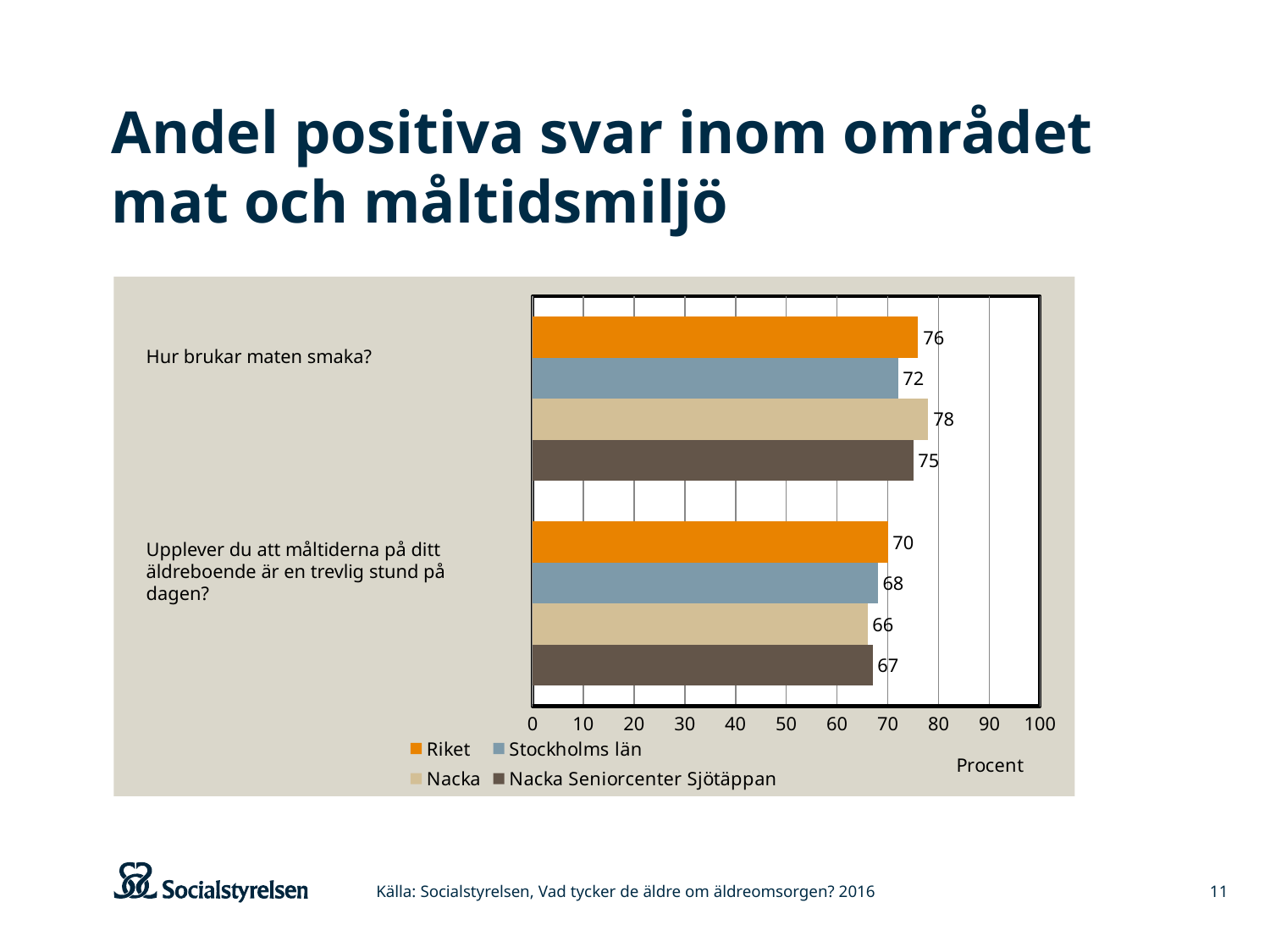
What is the difference between the Nacka value and the Stockholms län value for "Hur brukar maten smaka?"? 6 What kind of chart is shown on the slide? Bar chart What unit is shown on the x axis of the chart? Procent How many questions (categories) are shown on the chart? 2 What is the value for Stockholms län for "Hur brukar maten smaka?"? 72 For "Upplever du att måltiderna på ditt äldreboende är en trevlig stund på dagen?", which is larger: Riket or Stockholms län? Riket Which series has the lowest value for "Upplever du att måltiderna på ditt äldreboende är en trevlig stund på dagen?"? Nacka How many series does the legend list? 4 What is the value for Riket for the question "Hur brukar maten smaka?"? 76 What is the value for Nacka Seniorcenter Sjötäppan for "Upplever du att måltiderna på ditt äldreboende är en trevlig stund på dagen?"? 67 Is the Nacka value for "Hur brukar maten smaka?" greater or less than 70? greater Which series has the highest value for "Hur brukar maten smaka?"? Nacka